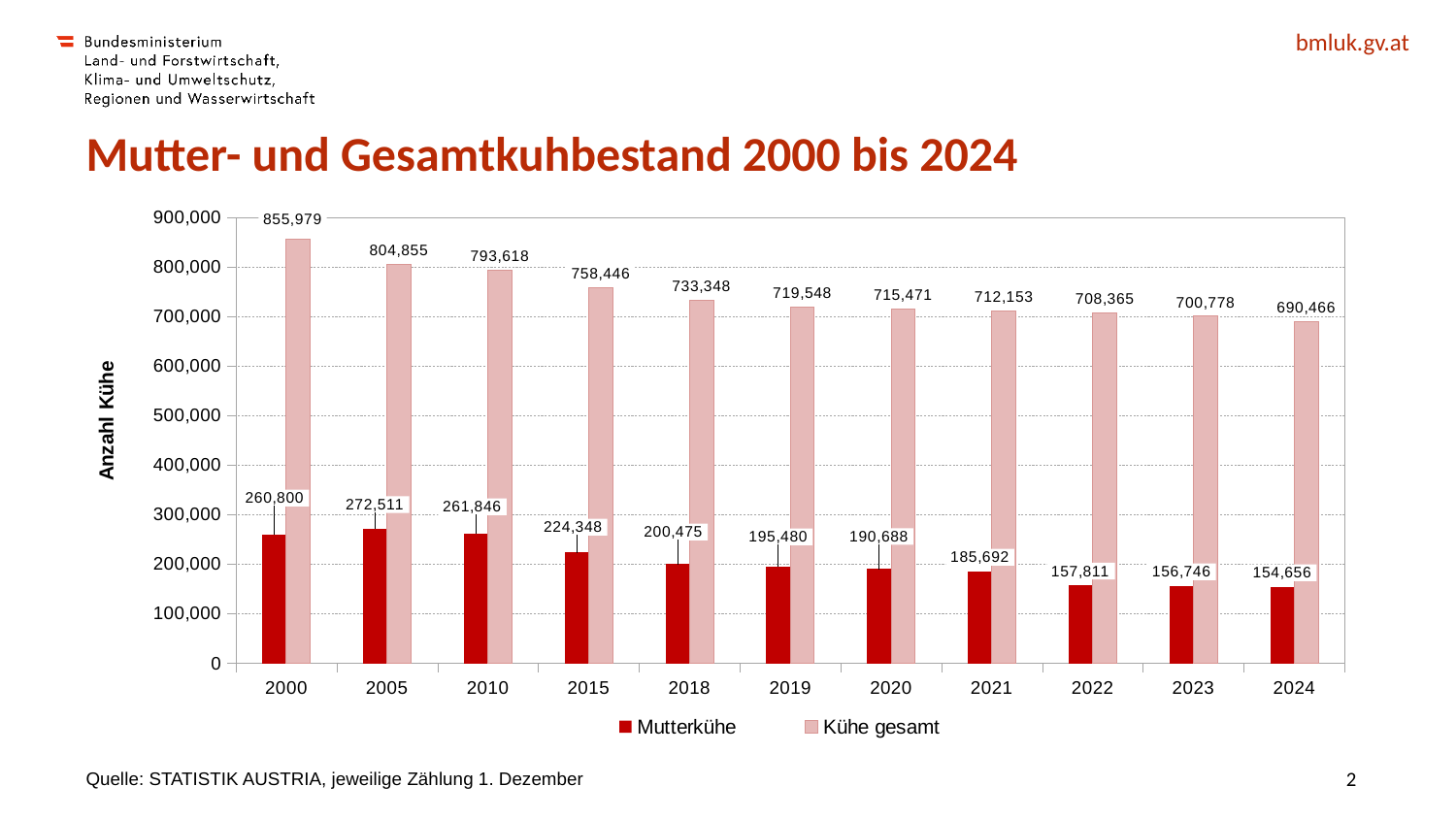
What is the difference between the Mutterkühe values for 2005 and 2000? 11,711 In which year is the Kühe gesamt value lowest? 2024 How many years are shown on the x axis? 11 Which is larger: the Mutterkühe value for 2018 or for 2019? 2018 What is the value for Kühe gesamt in 2000? 855,979 How many series does the legend list? 2 What is the value for Mutterkühe in 2024? 154,656 Do the Kühe gesamt values rise or fall from 2000 to 2024? fall What is the value for Mutterkühe in 2015? 224,348 What is the difference between the Kühe gesamt values for 2000 and 2024? 165,513 In which year is the Mutterkühe value highest? 2005 What is the value for Kühe gesamt in 2019? 719,548